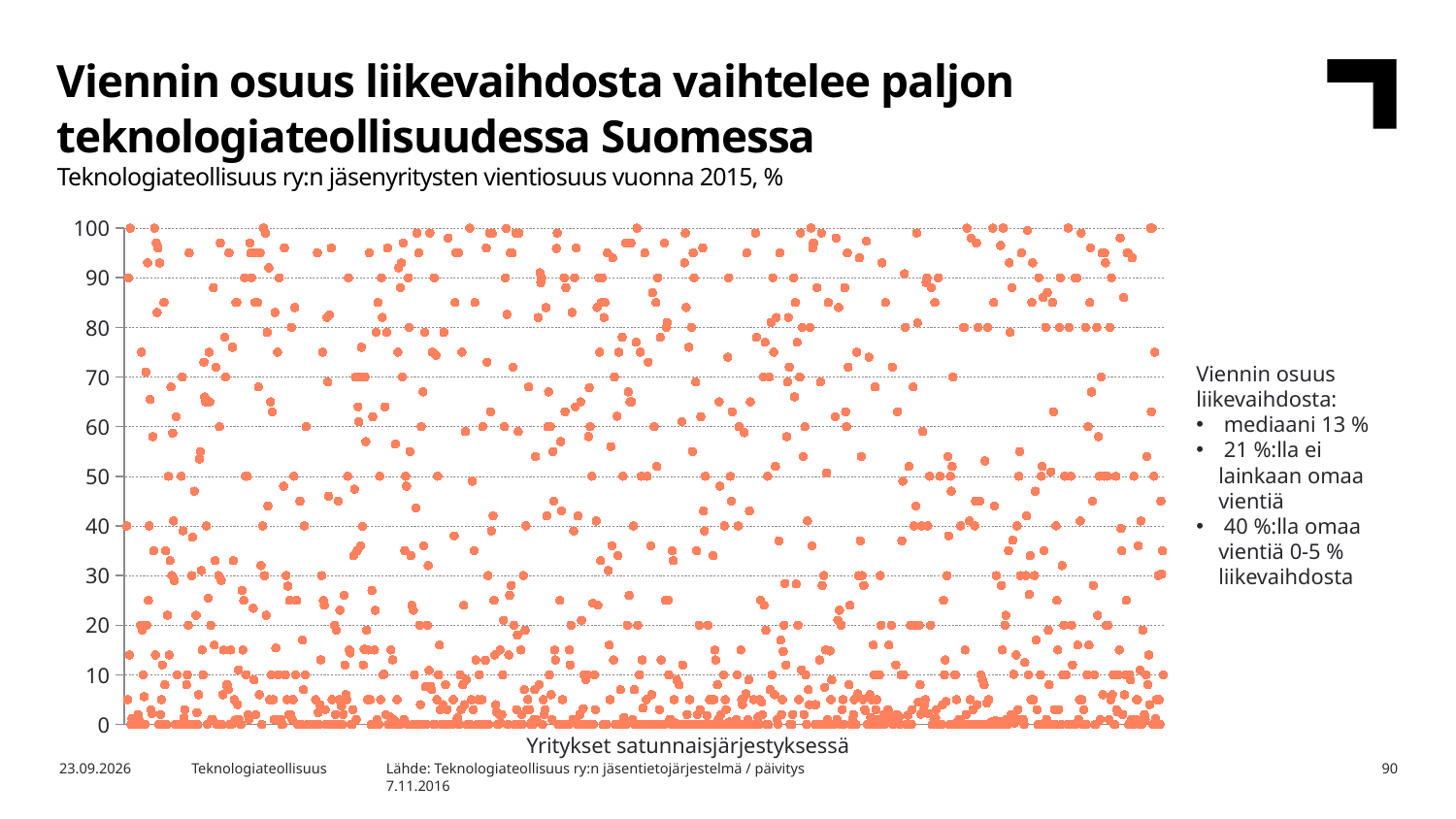
What is the label of the x axis of the chart? Yritykset satunnaisjärjestyksessä What is the difference between the share of companies with exports of 0-5 % of turnover and the share with no exports at all? 19 % According to the annotation next to the chart, what share of companies have no exports at all? 21 % What kind of chart is shown on the slide? Scatter chart Is the share of companies with exports of 0-5 % of turnover larger or smaller than the share with no exports at all? Larger What is the highest export share value plotted in the chart? 100 What is the lowest export share value plotted in the chart? 0 According to the annotation next to the chart, what share of companies have exports of 0-5 % of turnover? 40 % According to the annotation next to the chart, what is the median export share of turnover? 13 % What is the title of the chart on the slide? Viennin osuus liikevaihdosta vaihtelee paljon teknologiateollisuudessa Suomessa